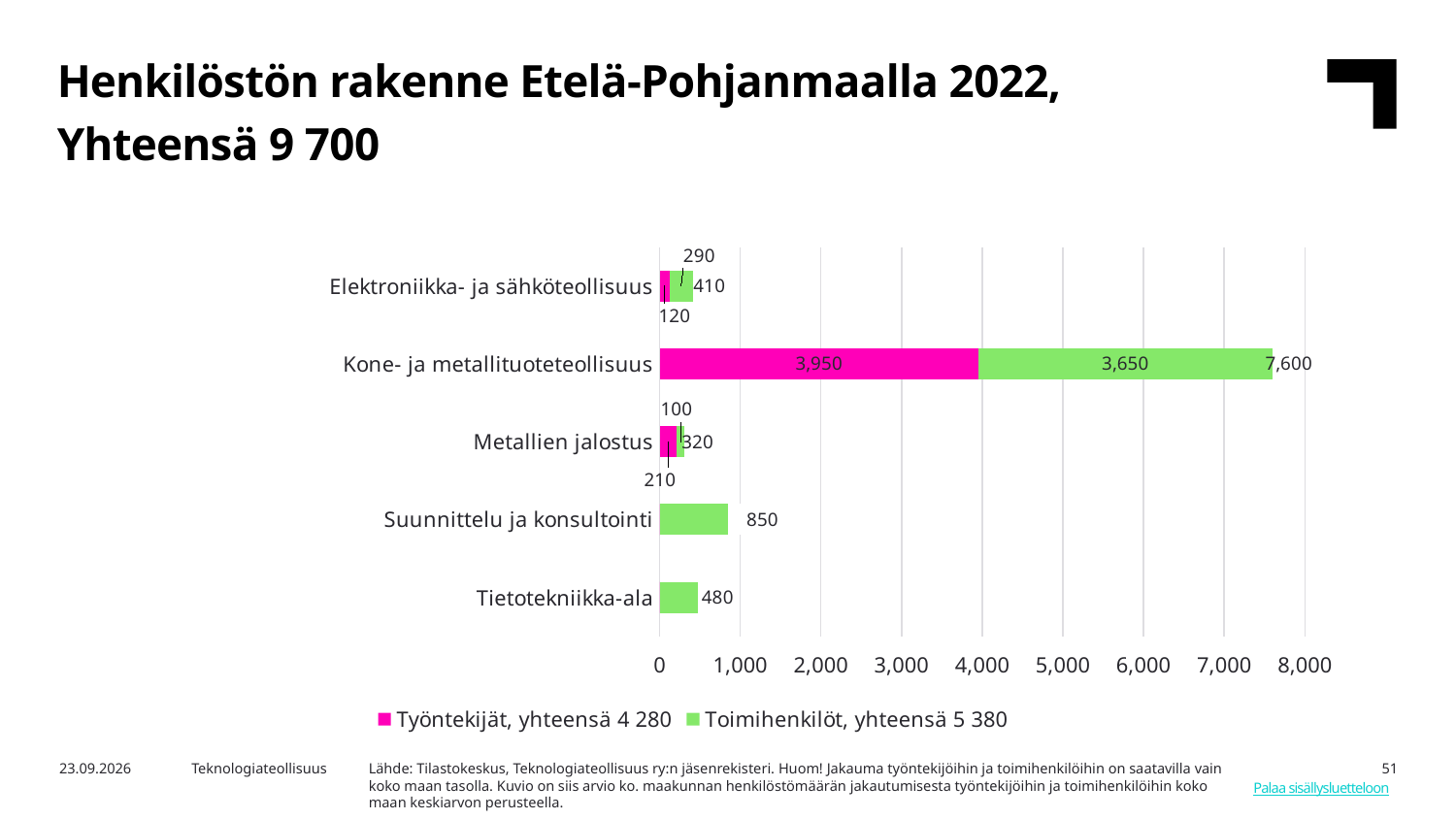
What is the value shown for Suunnittelu ja konsultointi? 850 What total does the legend give for Työntekijät? 4 280 What is the difference between the Työntekijät and Toimihenkilöt values for Kone- ja metallituoteteollisuus? 300 What is the value shown for Tietotekniikka-ala? 480 What is the Työntekijät value for Kone- ja metallituoteteollisuus? 3,950 What is the Toimihenkilöt value for Kone- ja metallituoteteollisuus? 3,650 How many categories are shown on the chart? 5 How many series does the legend list? 2 Which is larger, the value for Suunnittelu ja konsultointi or the value for Tietotekniikka-ala? Suunnittelu ja konsultointi What kind of chart is shown on the slide? bar chart What is the total of the stacked bar for Kone- ja metallituoteteollisuus? 7,600 Which category has the highest total? Kone- ja metallituoteteollisuus